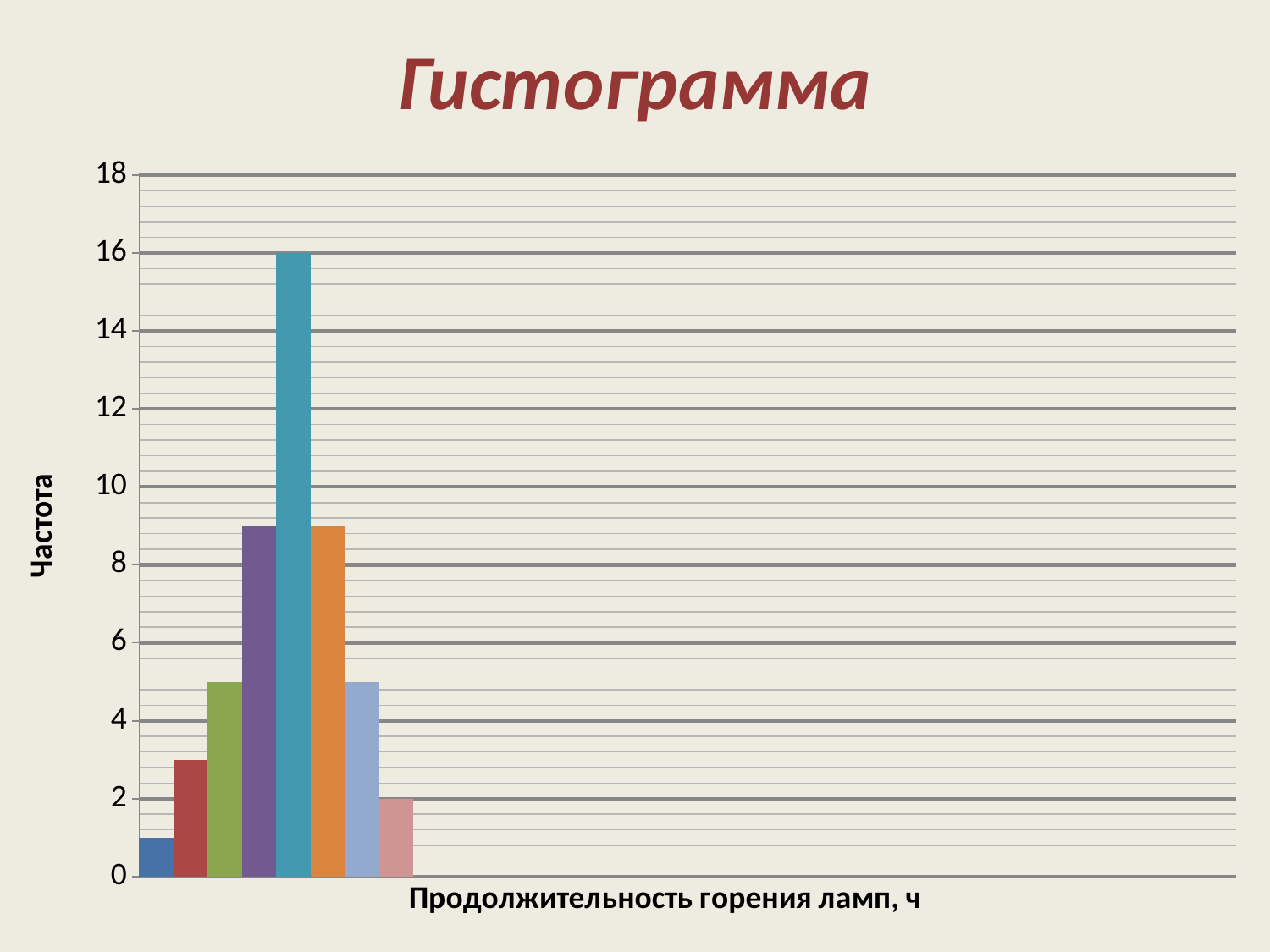
Is the value of the sixth bar from the left (orange) greater or less than 10? less Which bar is the shortest in the chart? the first bar from the left (dark blue) What kind of chart is shown on the slide? bar chart Is the value of the third bar from the left (green) greater or less than 6? less What is the value of the tallest (teal) bar? 16 Is the value of the fourth bar from the left (purple) greater or less than 8? greater What is the difference between the tallest bar and the rightmost bar? 14 What is the label of the vertical axis? Частота How many bars are plotted in the chart? 8 What is the value of the rightmost (pink) bar? 2 Which bar is the tallest in the chart? the fifth bar from the left (teal) Which is taller: the second bar from the left (red) or the seventh bar from the left (light blue)? the seventh bar (light blue)